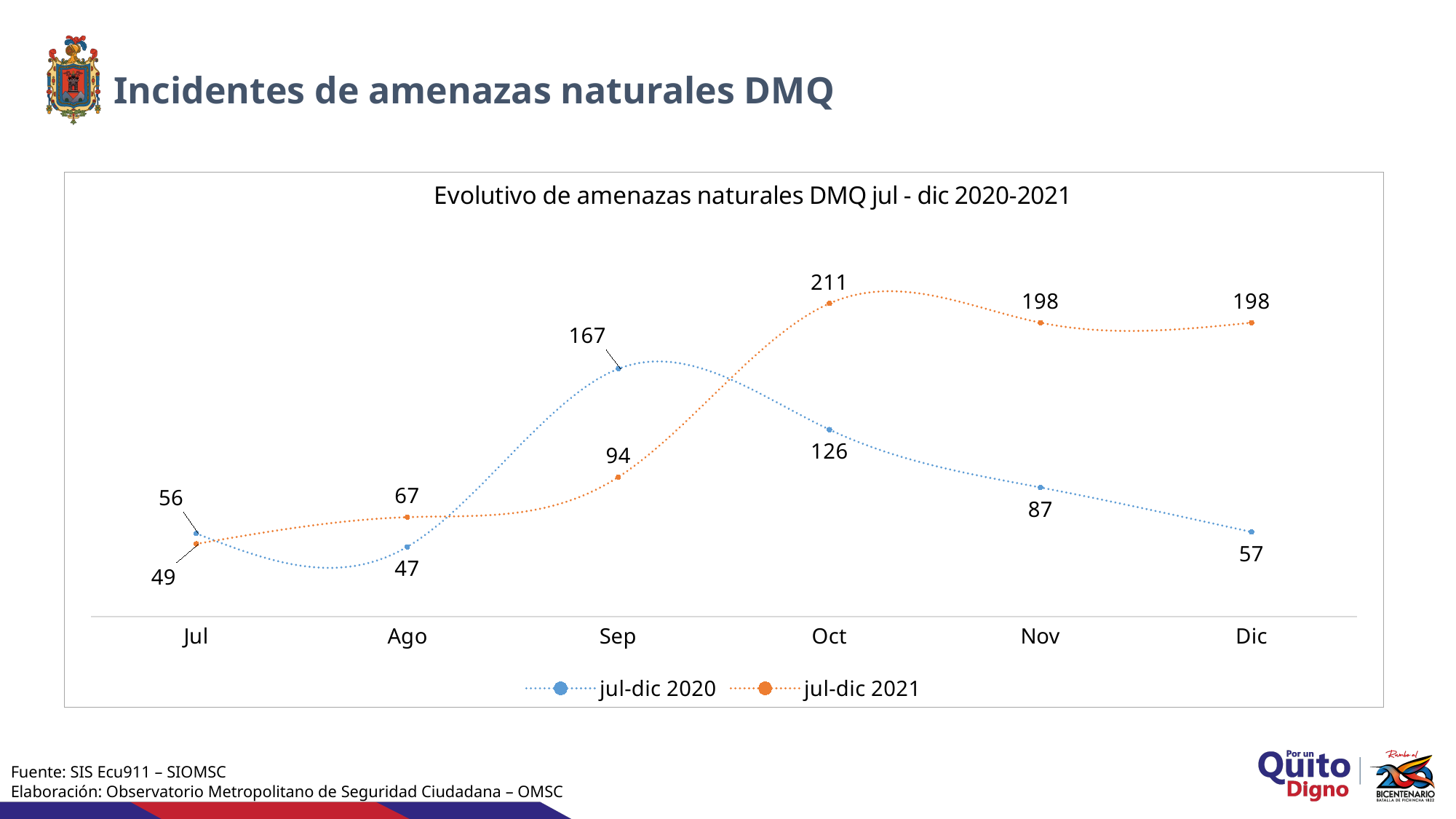
What is the value for Oct in the jul-dic 2021 series? 211 What is the difference between the jul-dic 2021 and jul-dic 2020 values for Dic? 141 Which series has the larger value for Sep, jul-dic 2020 or jul-dic 2021? jul-dic 2020 What is the value for Sep in the jul-dic 2020 series? 167 Does the jul-dic 2020 series rise or fall from Sep to Dic? fall How many series does the legend list? 2 What kind of chart is shown? line chart Which month has the lowest value in the jul-dic 2020 series? Ago Which month has the highest value in the jul-dic 2021 series? Oct What is the value for Jul in the jul-dic 2021 series? 49 How many months are shown on the x axis? 6 What is the title of the chart? Evolutivo de amenazas naturales DMQ jul - dic 2020-2021